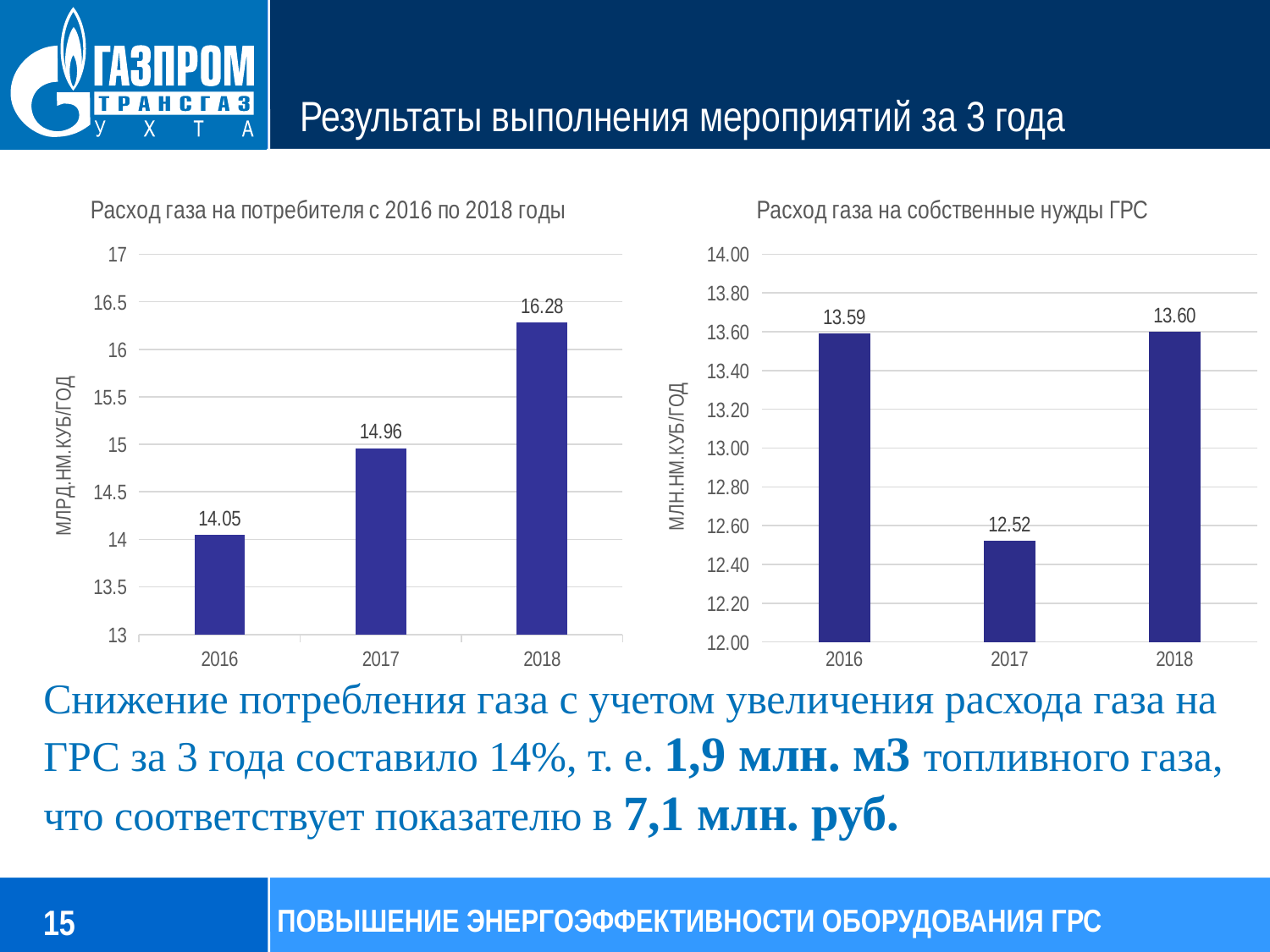
What type of chart is the left chart ("Расход газа на потребителя с 2016 по 2018 годы")? bar chart In the chart titled "Расход газа на собственные нужды ГРС", what is the value for 2016? 13.59 In the chart titled "Расход газа на потребителя с 2016 по 2018 годы", what is the value for 2016? 14.05 In the right chart ("Расход газа на собственные нужды ГРС"), which year has the lowest value? 2017 In the right chart ("Расход газа на собственные нужды ГРС"), what is the difference between the 2016 and 2017 values? 1.07 In the left chart ("Расход газа на потребителя с 2016 по 2018 годы"), what is the difference between the 2018 and 2016 values? 2.23 In the chart titled "Расход газа на собственные нужды ГРС", what is the value for 2017? 12.52 In the left chart ("Расход газа на потребителя с 2016 по 2018 годы"), which is larger, the value for 2017 or the value for 2016? 2017 In the left chart ("Расход газа на потребителя с 2016 по 2018 годы"), do the values rise or fall from 2016 to 2018? rise In the left chart ("Расход газа на потребителя с 2016 по 2018 годы"), which year has the highest value? 2018 In the chart titled "Расход газа на потребителя с 2016 по 2018 годы", what is the value for 2018? 16.28 How many years are shown on the x axis of the right chart ("Расход газа на собственные нужды ГРС")? 3